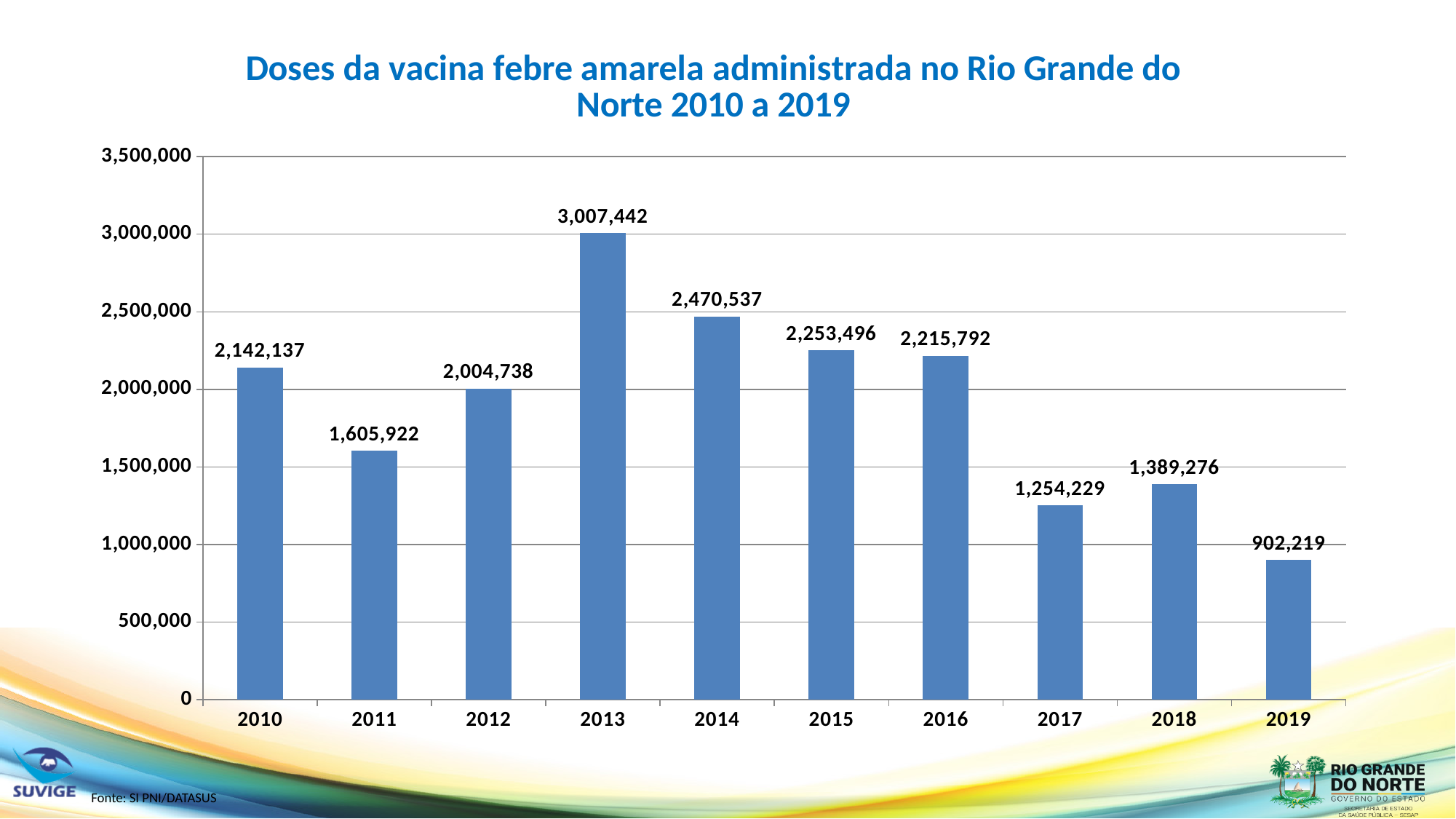
What is the difference between the values for 2013 and 2019? 2,105,223 What is the difference between the values for 2014 and 2015? 217,041 Do the values rise or fall from 2013 to 2017? Fall What is the value shown for 2019? 902,219 Which year has the highest number of doses administered? 2013 What is the value shown for 2011? 1,605,922 Which year has the lowest number of doses administered? 2019 How many doses of yellow fever vaccine were administered in 2013? 3,007,442 Which year has a larger value, 2017 or 2018? 2018 What kind of chart is shown on the slide? Bar chart Is the value for 2012 greater or less than 2,500,000? less How many years are shown on the x axis? 10